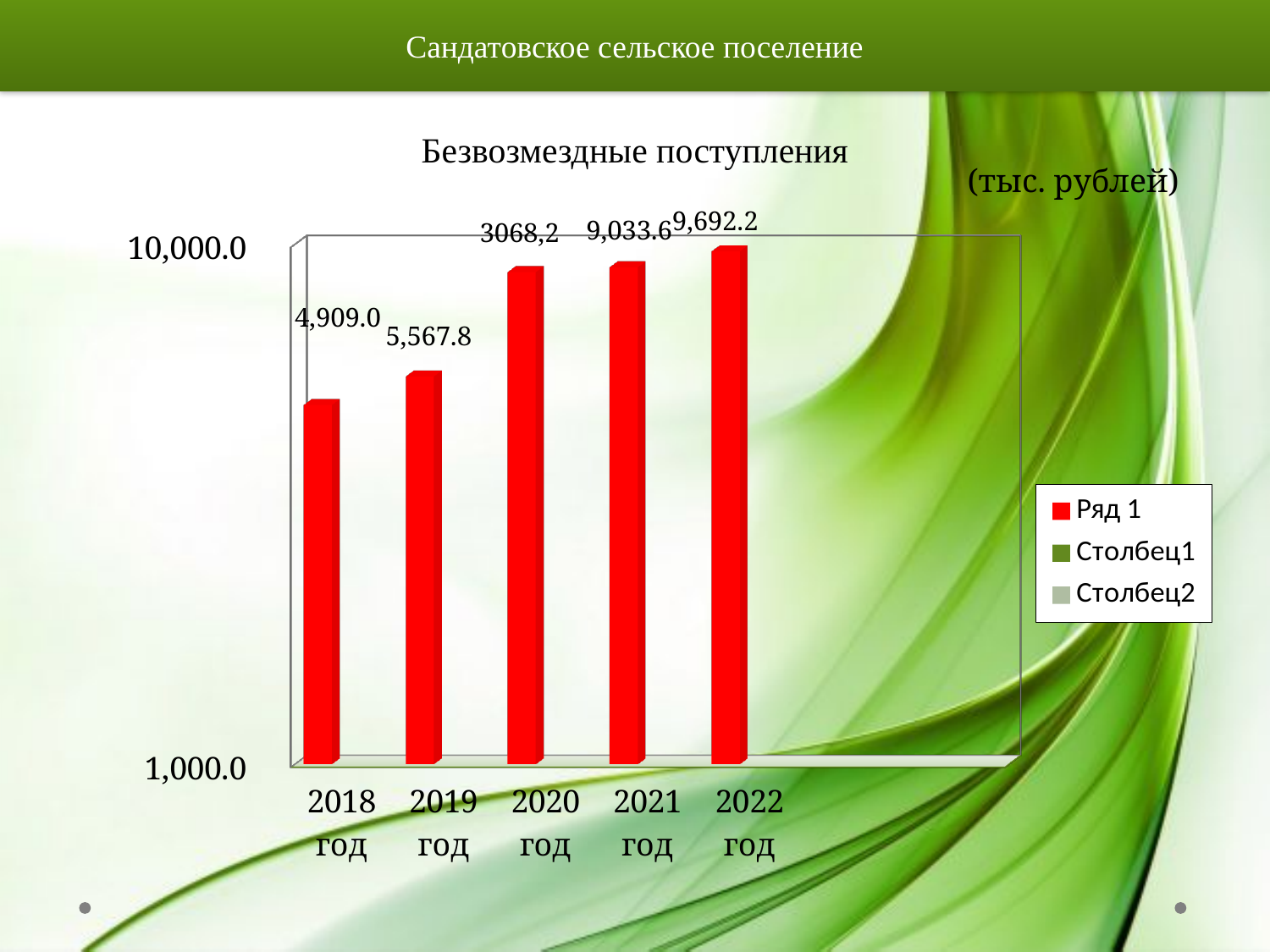
What type of chart is shown on the slide? bar chart What is the difference between the values for 2022 год and 2021 год? 658.6 What is the value for 2018 год? 4,909.0 How many series does the legend list? 3 How many years are shown on the x axis? 5 What is the value for 2022 год? 9,692.2 Do the bar heights rise or fall from 2018 год to 2022 год? rise What is the value for 2021 год? 9,033.6 What is the value for 2019 год? 5,567.8 What is the title of the chart? Безвозмездные поступления Which year has the highest value? 2022 год Which is larger, the value for 2021 год or the value for 2019 год? 2021 год